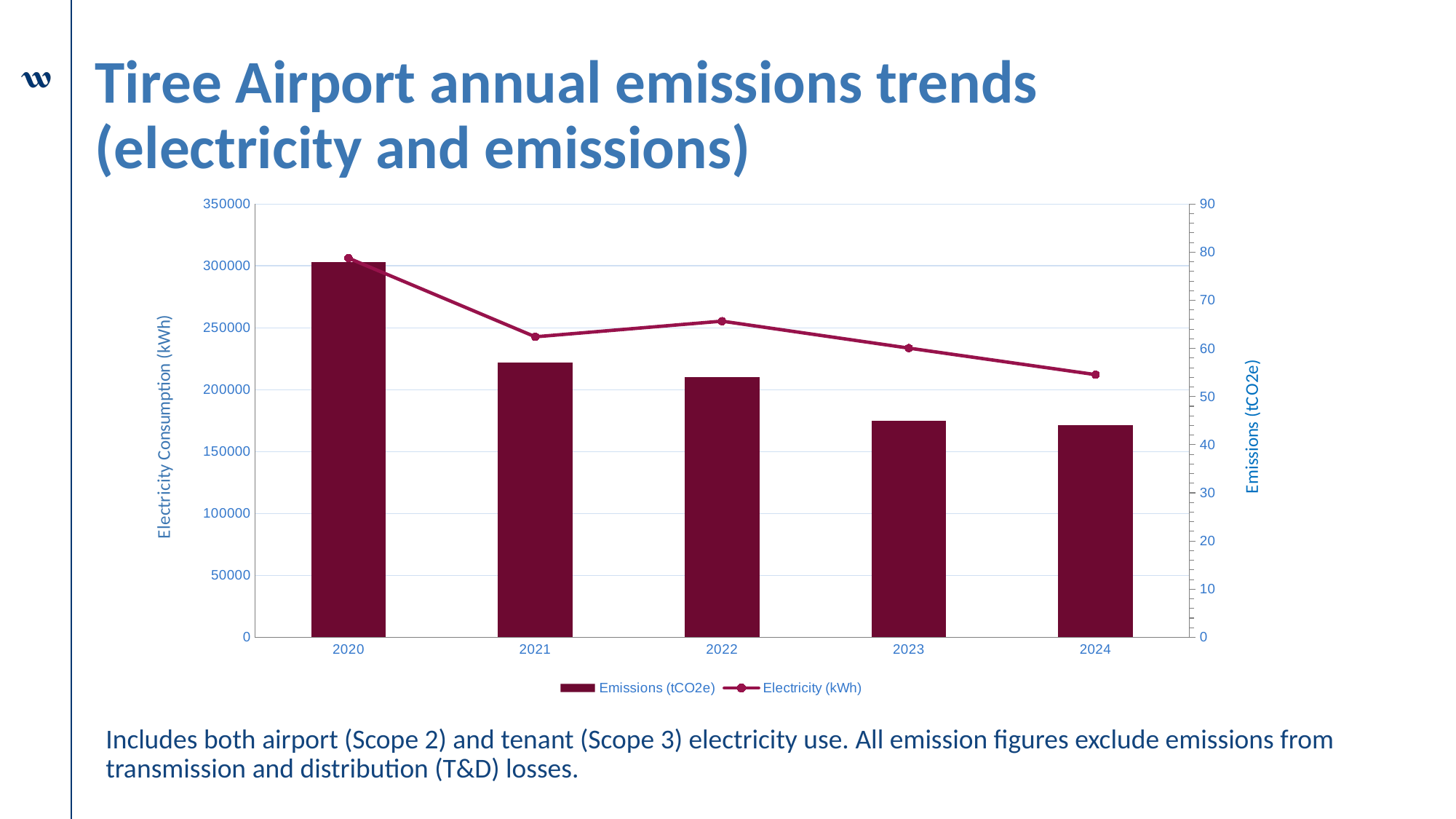
Is the bar for 2023 greater or less than 200000 on the left axis? less Is the bar for 2021 greater or less than 200000 on the left axis? greater Is the line value for 2020 greater or less than 70 on the right axis? greater What kind of chart is shown on the slide? A combination bar and line chart In which year does the line series reach its lowest point? 2024 What is the label on the right-hand vertical axis of the chart? Emissions (tCO2e) In which year does the line series reach its highest point? 2020 Which year has the tallest bar in the chart? 2020 How many series does the chart legend list? 2 How many years are shown on the x axis of the chart? 5 Do the bar values generally rise or fall from 2020 to 2024? fall